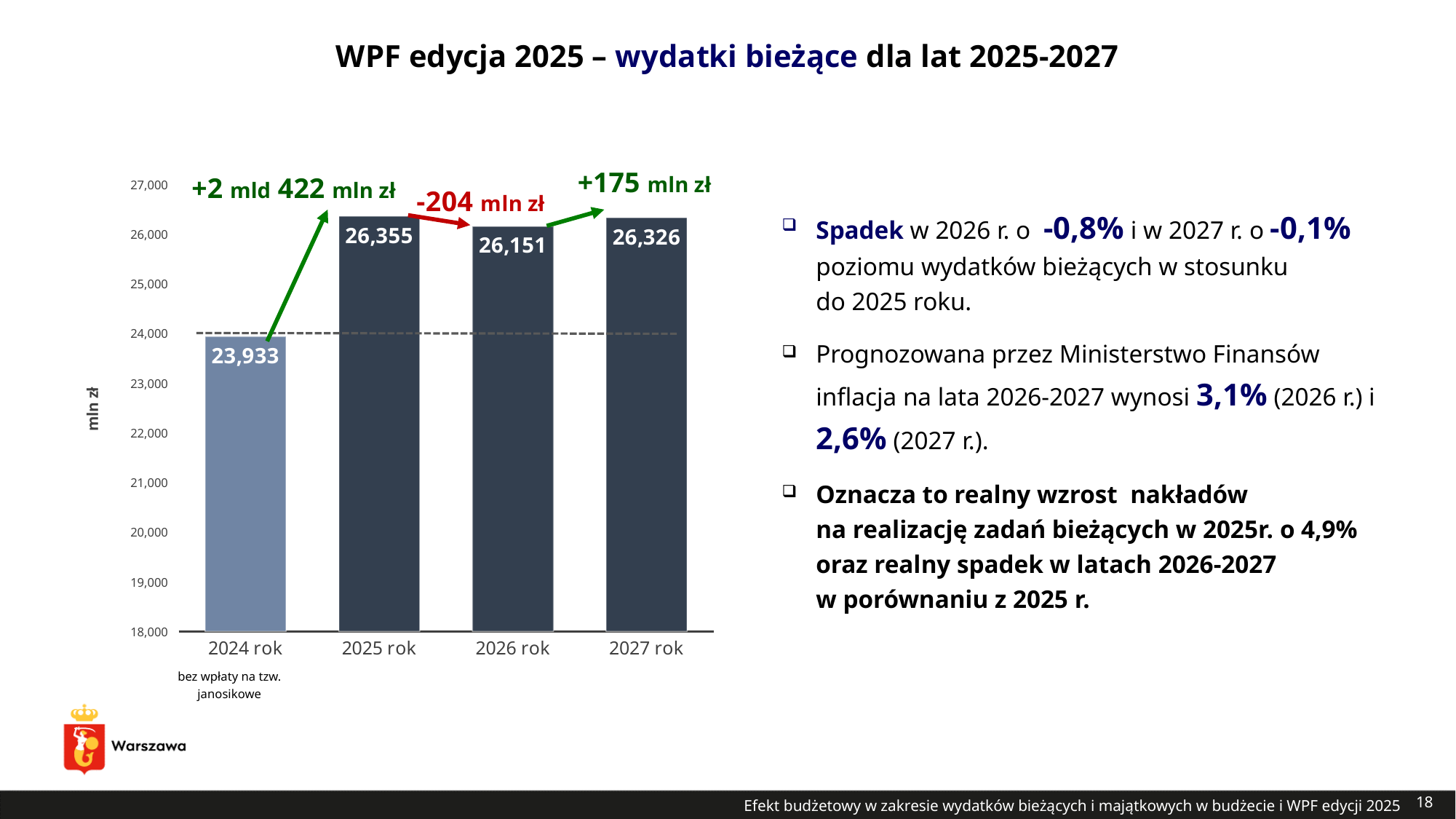
Which year has the lowest value? 2024 rok Which year has the highest value? 2025 rok What is the value for 2027 rok? 26,326 What is the difference between the values for 2025 rok and 2024 rok? 2,422 What kind of chart is shown on the slide? bar chart Which is larger, the value for 2026 rok or the value for 2027 rok? 2027 rok What is the value for 2026 rok? 26,151 How many bars are shown in the chart? 4 What is the value for 2024 rok? 23,933 What is the value for 2025 rok? 26,355 What is the difference between the values for 2025 rok and 2026 rok? 204 Is the value for 2024 rok greater or less than 24,000? less